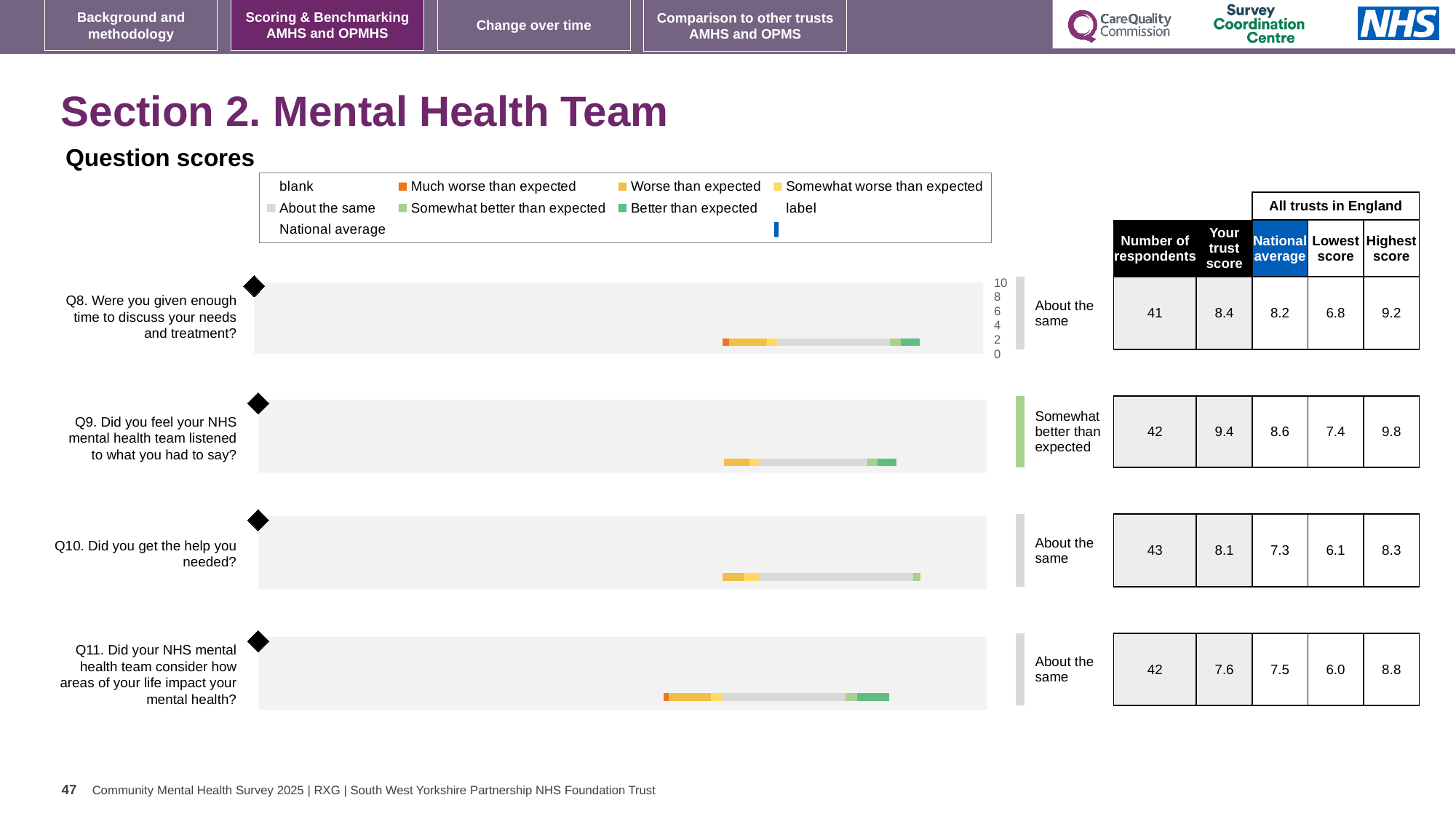
In the table beside the charts, what is the lowest score across all trusts in England for Q11? 6.0 In the table beside the charts, how many respondents answered Q10? 43 What benchmark category is shown next to the bar for Q10? About the same What benchmark category is shown next to the bar for Q9? Somewhat better than expected In the table beside the charts, what is the difference between the trust score and the national average for Q9? 0.8 In the table beside the charts, what is the 'Your trust score' for Q9? 9.4 Which question has the highest 'Your trust score' in the table beside the charts? Q9 Which question has the fewest respondents in the table beside the charts? Q8 What kind of chart is used to show the question scores for Q8 to Q11? bar chart In the table beside the charts, what is the highest score across all trusts in England for Q8? 9.2 In the table beside the charts, what is the national average for Q11? 7.5 How many questions (Q8 to Q11) have a score bar plotted on the slide? 4